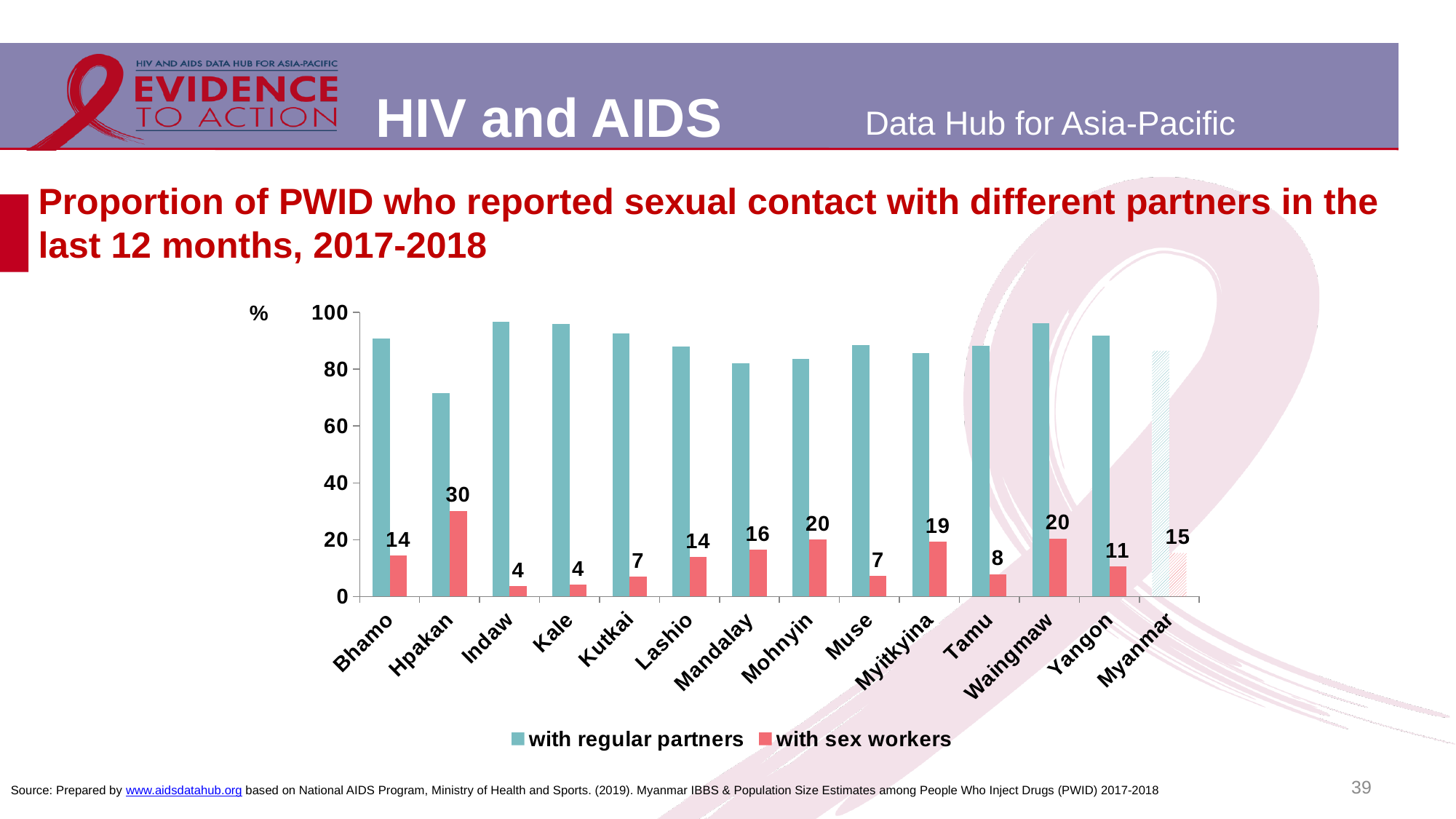
What is the value for Yangon in the 'with sex workers' series? 11 What is the value for Myanmar in the 'with sex workers' series? 15 Which series is shown in red in the legend? with sex workers What is the difference between the 'with sex workers' values for Hpakan and Yangon? 19 What kind of chart is shown on the slide? bar chart How many series does the legend list? 2 Which category has the highest value in the 'with sex workers' series? Hpakan Is the value for Indaw in the 'with regular partners' series greater or less than 80? greater How many categories are shown on the x axis? 14 Is the value for Hpakan in the 'with regular partners' series greater or less than 80? less What is the value for Hpakan in the 'with sex workers' series? 30 Which is larger in the 'with sex workers' series: Mohnyin or Tamu? Mohnyin